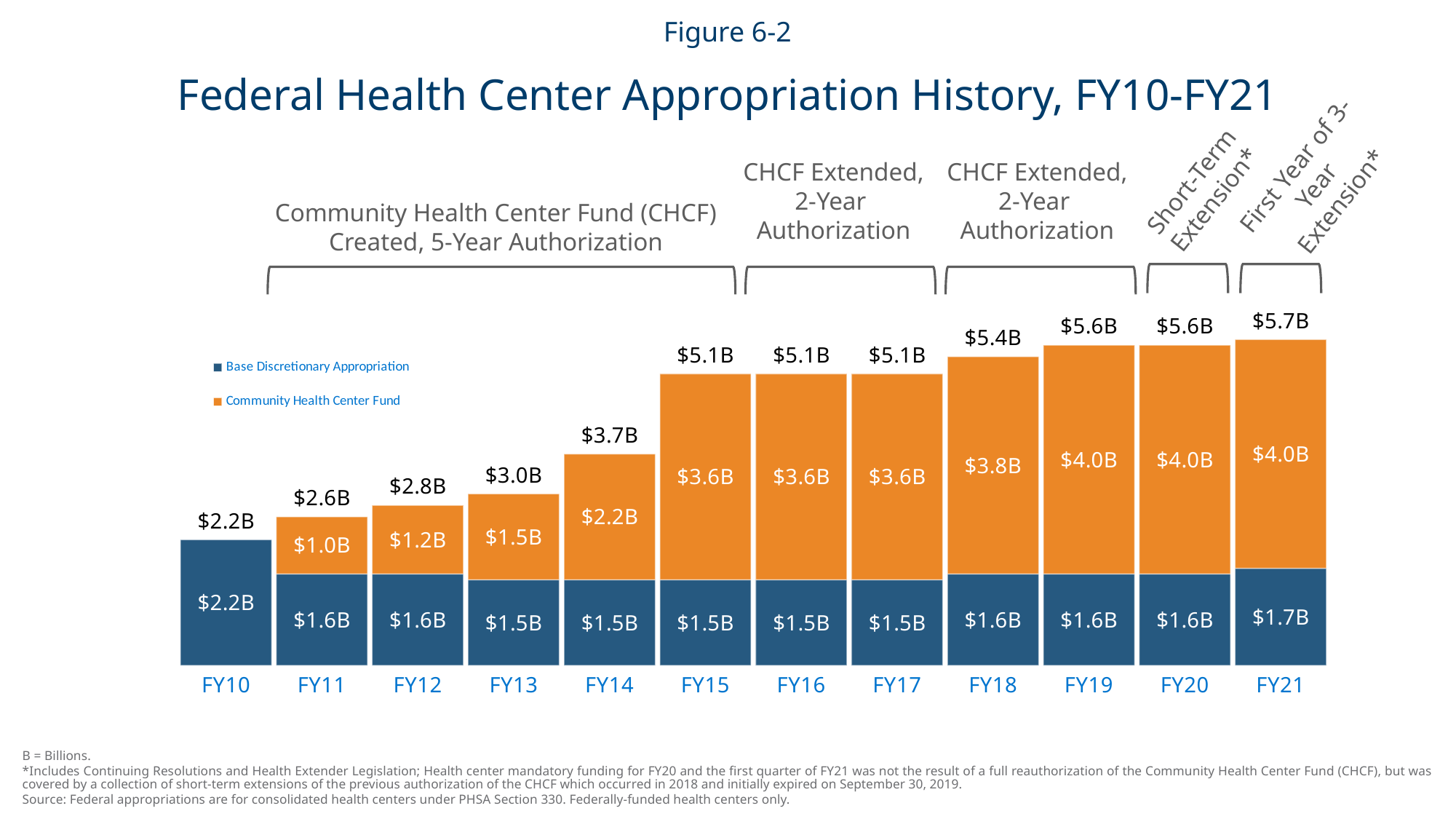
Which is larger, the Community Health Center Fund value for FY14 or for FY13? FY14 What is the title of the chart? Federal Health Center Appropriation History, FY10-FY21 What is the total appropriation shown for FY18? $5.4B Do the total appropriations generally rise or fall from FY10 to FY21? Rise What is the Community Health Center Fund value for FY15? $3.6B How many fiscal years are shown on the chart? 12 What is the Base Discretionary Appropriation value for FY21? $1.7B Which fiscal year has the lowest total appropriation? FY10 What is the difference between the total appropriation for FY21 and FY10? $3.5B What kind of chart is this? Stacked bar chart How many series does the legend list? 2 Which fiscal year has the highest total appropriation? FY21